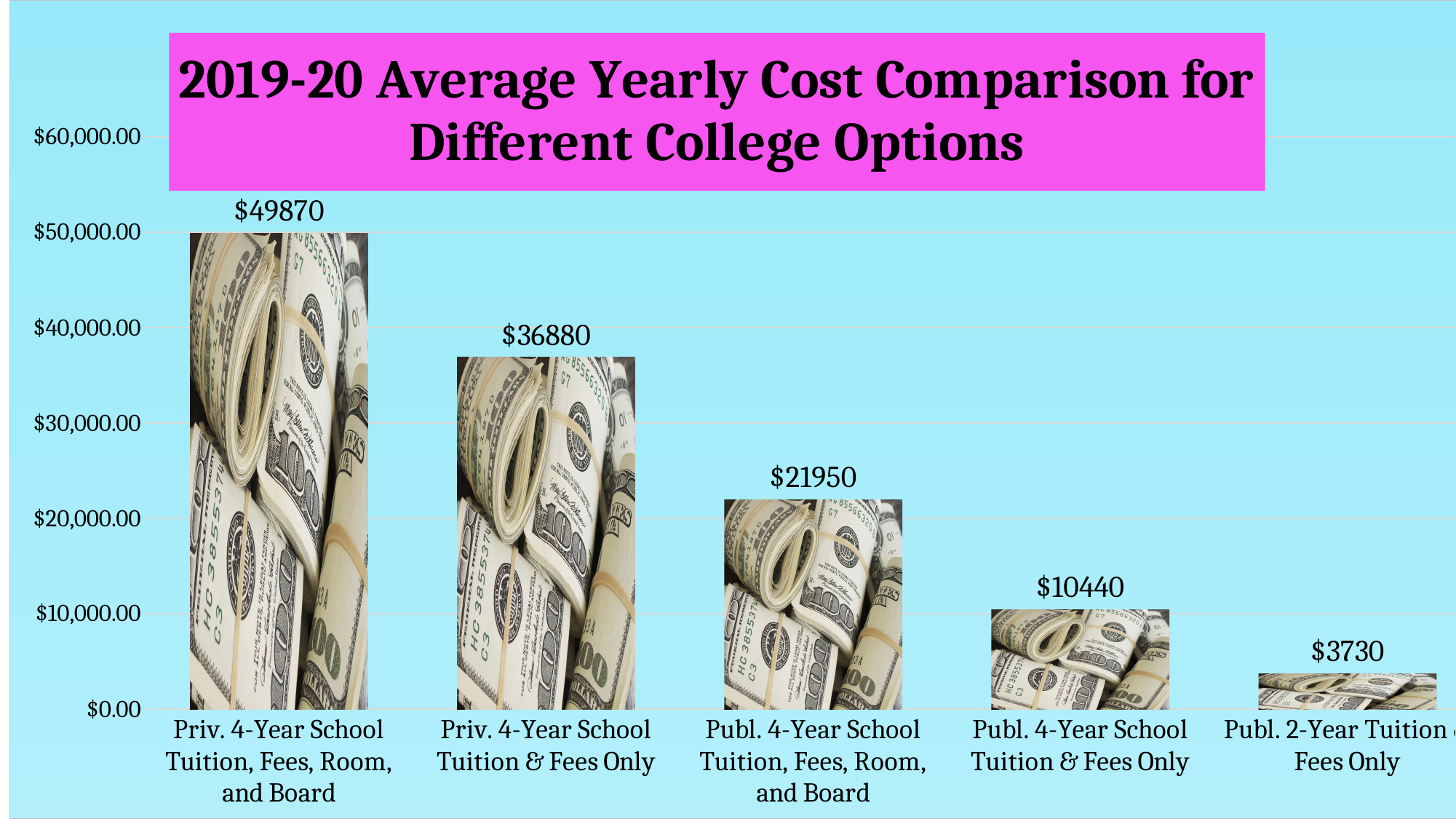
What is the value for Priv. 4-Year School Tuition, Fees, Room, and Board? $49870 Which is larger: Priv. 4-Year School Tuition & Fees Only or Publ. 4-Year School Tuition, Fees, Room, and Board? Priv. 4-Year School Tuition & Fees Only How many categories are shown in the chart? 5 Which category has the lowest value? Publ. 2-Year Tuition & Fees Only What is the title of the chart? 2019-20 Average Yearly Cost Comparison for Different College Options Is the value for Priv. 4-Year School Tuition & Fees Only greater or less than $40,000.00? less What is the value for Publ. 4-Year School Tuition, Fees, Room, and Board? $21950 What is the difference between Priv. 4-Year School Tuition, Fees, Room, and Board and Priv. 4-Year School Tuition & Fees Only? $12990 What is the value for Publ. 4-Year School Tuition & Fees Only? $10440 What kind of chart is shown on the slide? bar chart What is the difference between Publ. 4-Year School Tuition, Fees, Room, and Board and Publ. 4-Year School Tuition & Fees Only? $11510 Which category has the highest value? Priv. 4-Year School Tuition, Fees, Room, and Board